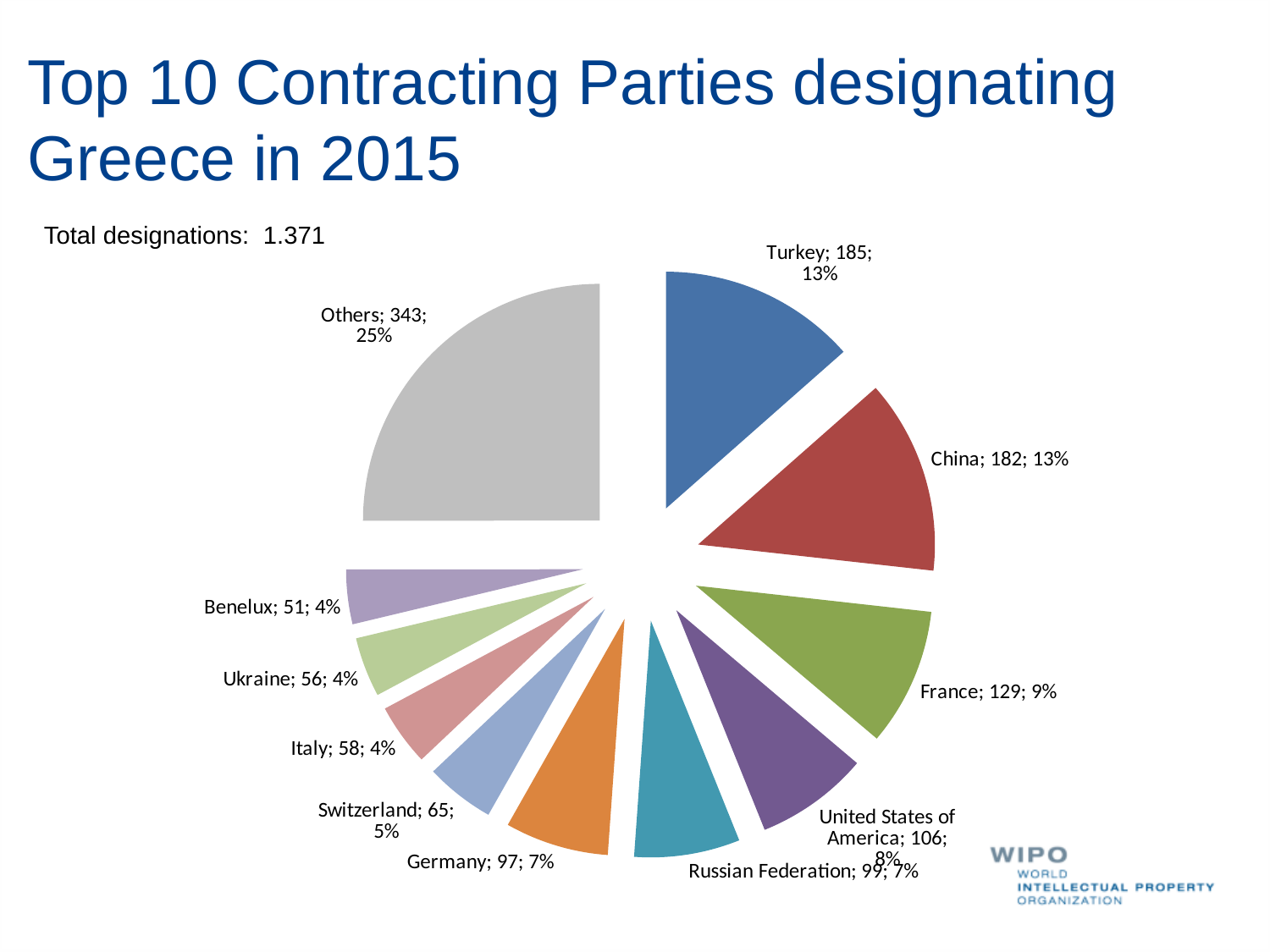
What kind of chart is shown on the slide? pie chart What share of the pie does China account for? 13% Which slice of the pie is the smallest? Benelux How many designations are attributed to France? 129 What is the difference in designations between Turkey and China? 3 How many slices does the pie chart have? 11 What share of the pie does the Others slice account for? 25% How many designations are attributed to Turkey? 185 What is the total number of designations stated on the slide? 1.371 Which slice of the pie is the largest? Others Which has more designations, Germany or the Russian Federation? Russian Federation What is the difference in designations between the United States of America and Switzerland? 41